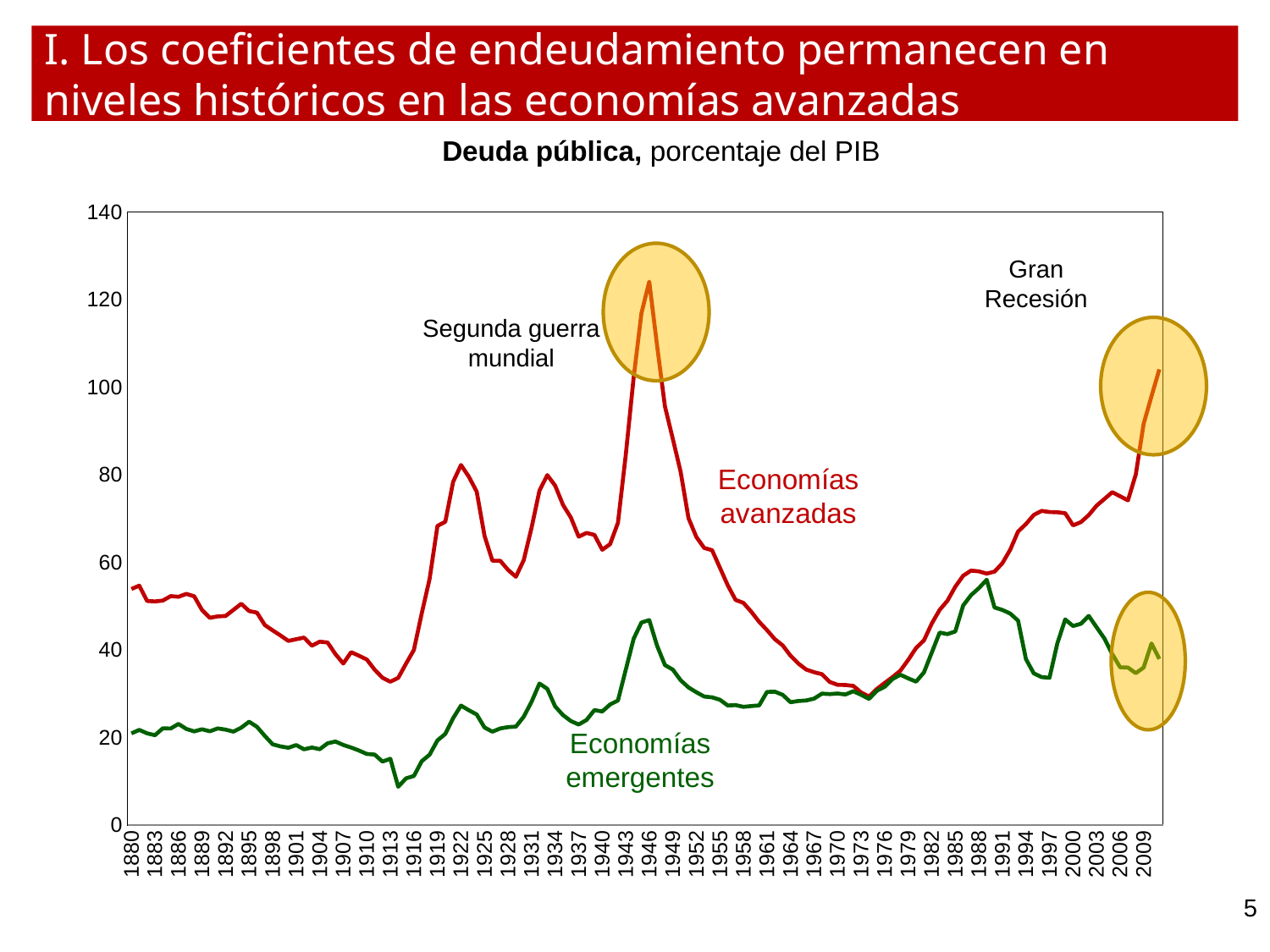
Is the value for Economías emergentes around 1913 greater or less than 20? less Around 1946, which series has the larger value, Economías avanzadas or Economías emergentes? Economías avanzadas Which historical event is labelled at the highest peak of the Economías avanzadas line? Segunda guerra mundial Does the Economías avanzadas line rise or fall between 1973 and 2009? rise Is the value for Economías avanzadas in 1880 greater or less than 40? greater How many series (lines) are plotted on the chart? 2 What is the title of the chart? Deuda pública, porcentaje del PIB What kind of chart is shown on the slide? line chart Is the value for Economías emergentes around 1946 greater or less than 60? less Does the Economías avanzadas line rise or fall between 1946 and 1973? fall